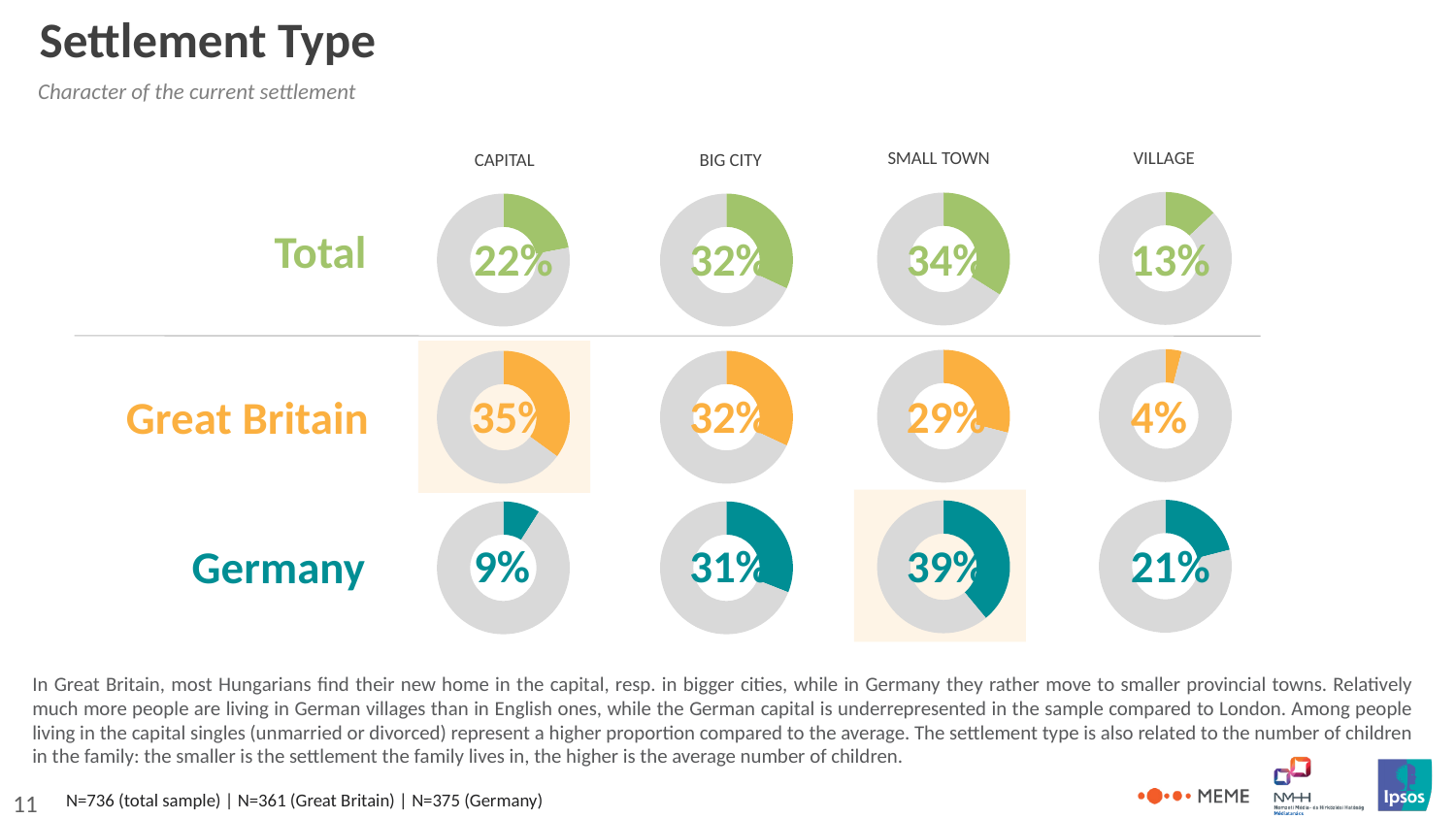
Which is larger: the Village percentage for Germany or the Village percentage for Great Britain? Germany How many settlement type categories are shown across the top of the charts? 4 In the Great Britain row, what percentage is shown for Village? 4% In the Total row, what percentage is shown for Capital? 22% What kind of chart is used to display each percentage on the slide? Donut chart In the Germany row, what percentage is shown for Small Town? 39% In the Germany row, what percentage is shown for Capital? 9% What is the difference between the Small Town percentage for Germany and for Great Britain? 10% In the Great Britain row, which settlement type has the highest percentage? Capital In the Total row, which settlement type has the lowest percentage? Village In the Germany row, which settlement type has the lowest percentage? Capital What is the difference between the Great Britain Capital percentage and the Germany Capital percentage? 26%